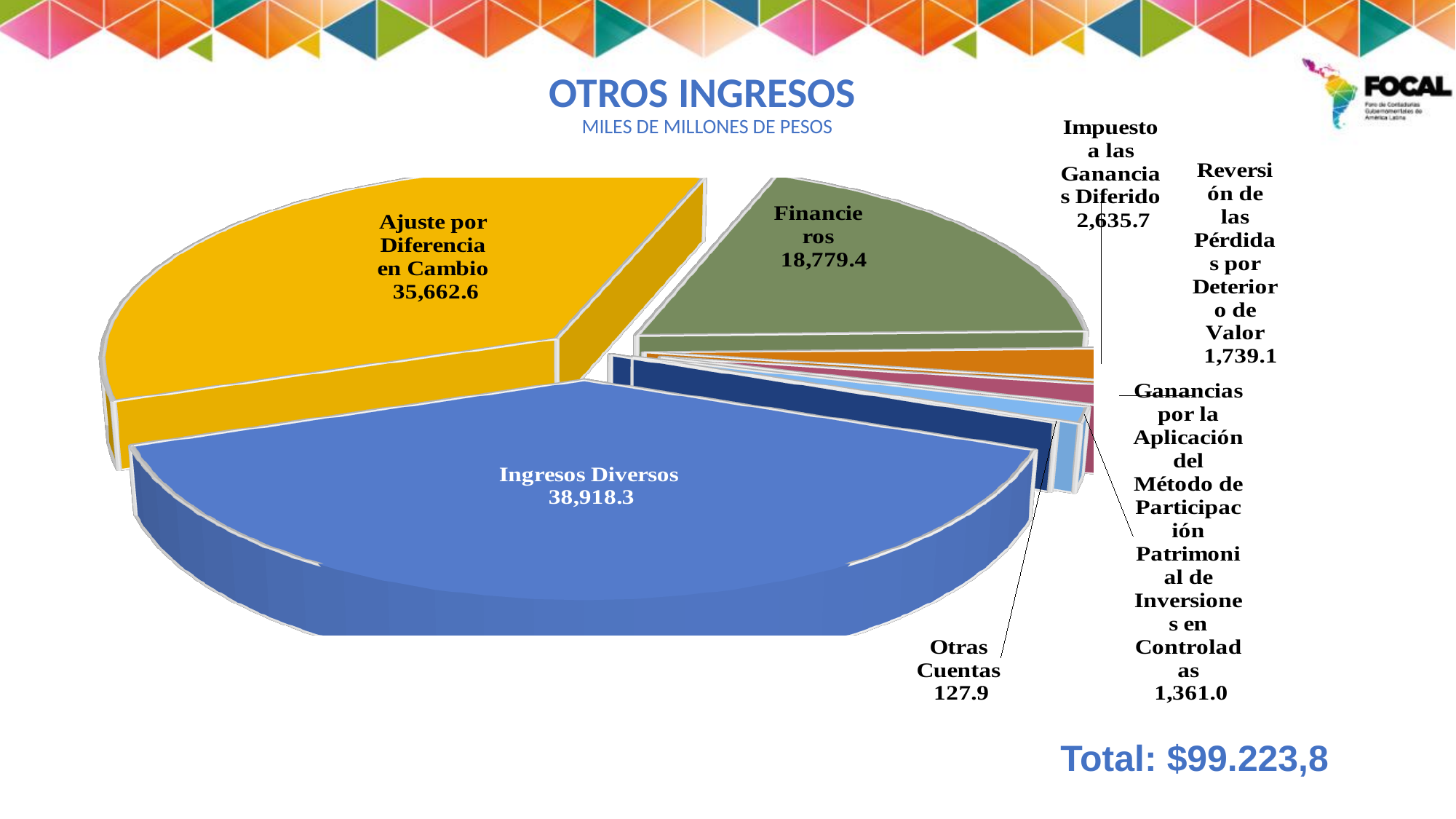
What is the value for Ingresos Diversos? 38,918.3 How many slices does the pie chart have? 7 What is the value for Financieros? 18,779.4 What is the value for Impuesto a las Ganancias Diferido? 2,635.7 What type of chart is shown on the slide? Pie chart What is the value for Ajuste por Diferencia en Cambio? 35,662.6 Which is larger, Ajuste por Diferencia en Cambio or Financieros? Ajuste por Diferencia en Cambio What total is shown on the slide for Otros Ingresos? $99.223,8 Which category has the largest slice of the pie? Ingresos Diversos What is the value for Otras Cuentas? 127.9 Which category has the smallest slice of the pie? Otras Cuentas What is the difference between Ingresos Diversos and Ajuste por Diferencia en Cambio? 3,255.7